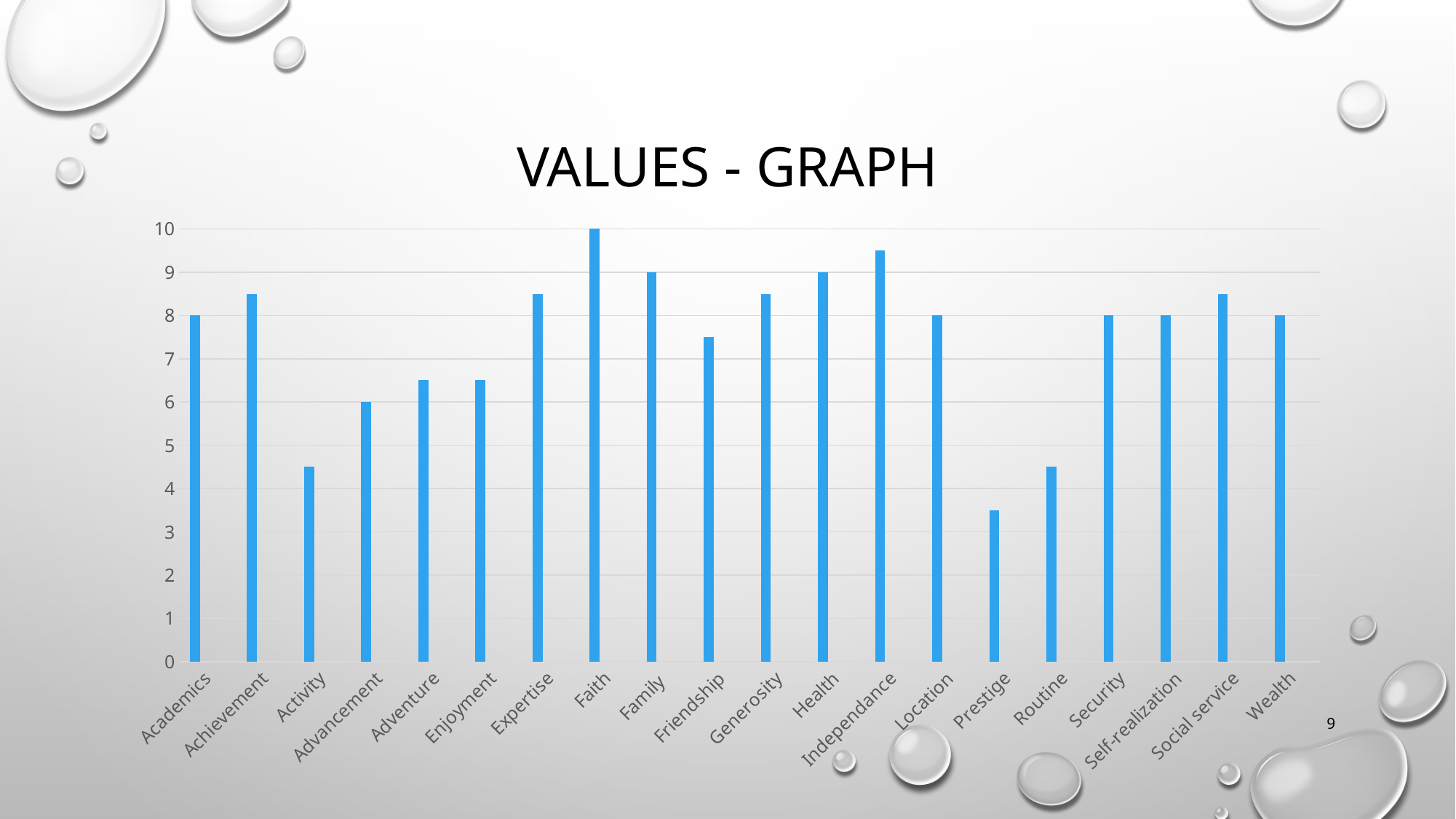
Which is larger, the value for Independance or the value for Location? Independance What is the difference between the values for Faith and Health? 1 What is the value for Wealth? 8 What is the value for Family? 9 What is the value for Faith? 10 What type of chart is shown on the slide? Bar chart Which category has the highest value? Faith How many categories are plotted on the chart? 20 Which category has the lowest value? Prestige What is the value for Advancement? 6 What is the title of the chart? VALUES - GRAPH Is the value for Prestige greater or less than 4? less